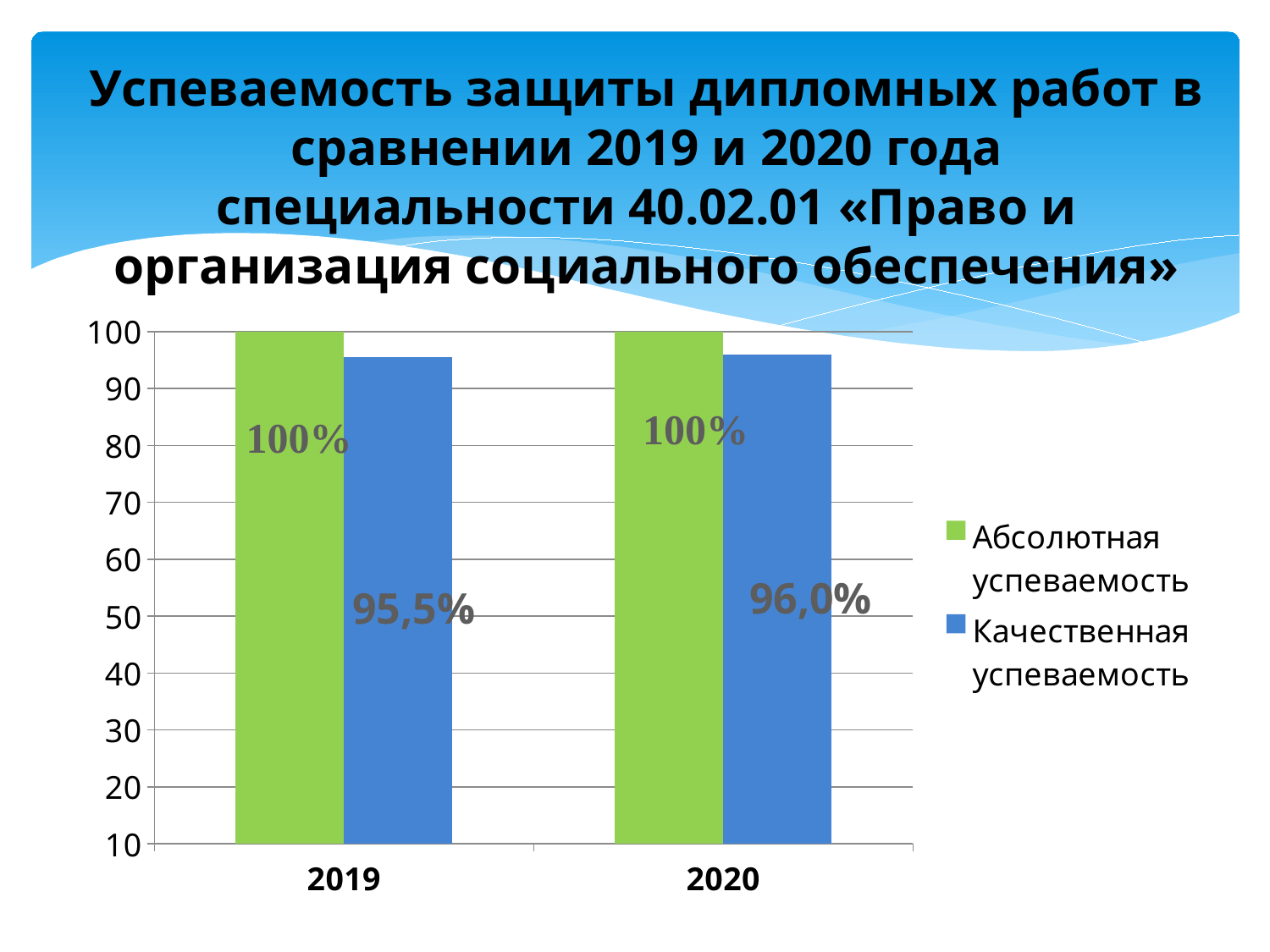
Which year has the higher value for Качественная успеваемость? 2020 How many years are shown on the x axis? 2 What is the difference between Абсолютная успеваемость and Качественная успеваемость in 2019? 4,5% What is the value of Качественная успеваемость for 2019? 95,5% How many series does the legend list? 2 What is the value of Абсолютная успеваемость for 2020? 100% What is the value of Качественная успеваемость for 2020? 96,0% Which year has the lower value for Качественная успеваемость? 2019 Is the value for Качественная успеваемость in 2019 greater or less than 90? greater What kind of chart is shown on the slide? bar chart Which is larger in 2020: Абсолютная успеваемость or Качественная успеваемость? Абсолютная успеваемость What is the value of Абсолютная успеваемость for 2019? 100%